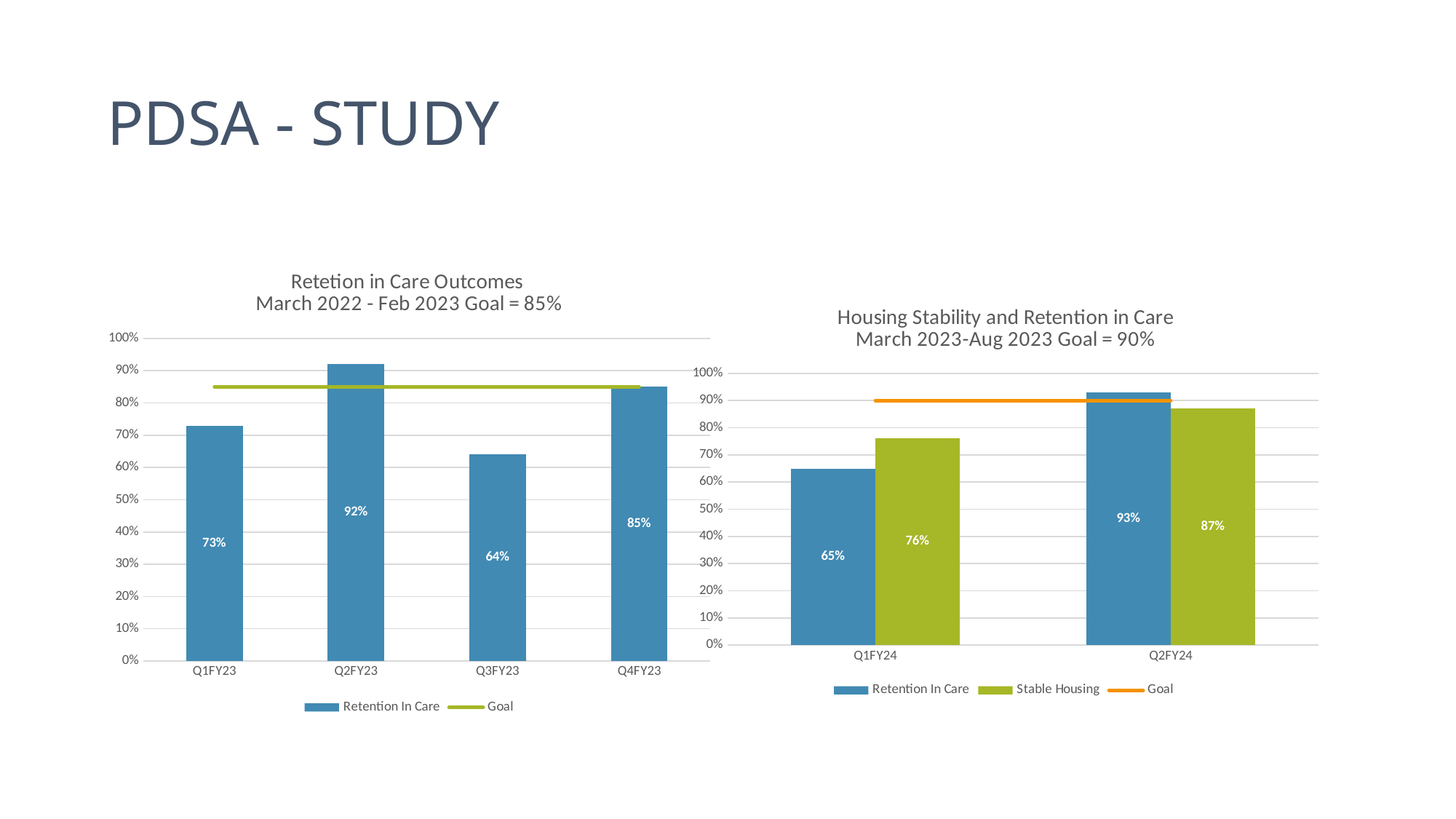
In the left chart (Retention in Care Outcomes), how many quarters are plotted on the x axis? 4 In the left chart (Retention in Care Outcomes), which quarter has the highest Retention In Care value? Q2FY23 In the right chart (Housing Stability and Retention in Care), which is larger for Q1FY24: Retention In Care or Stable Housing? Stable Housing In the right chart (Housing Stability and Retention in Care), how many entries does the legend list? 3 In the right chart (Housing Stability and Retention in Care), what is the difference between the Retention In Care values for Q2FY24 and Q1FY24? 28% In the left chart (Retention in Care Outcomes), is the Retention In Care value for Q1FY23 greater or less than 80%? less What type of chart is the left chart (Retention in Care Outcomes)? Bar chart with a goal line (combination bar and line chart) In the right chart (Housing Stability and Retention in Care), what is the Retention In Care value for Q2FY24? 93% In the left chart (Retention in Care Outcomes), what is the difference between the Q2FY23 and Q3FY23 Retention In Care values? 28% In the left chart (Retention in Care Outcomes), what is the Retention In Care value for Q2FY23? 92% In the right chart (Housing Stability and Retention in Care), what is the Stable Housing value for Q1FY24? 76% In the left chart (Retention in Care Outcomes), which quarter has the lowest Retention In Care value? Q3FY23